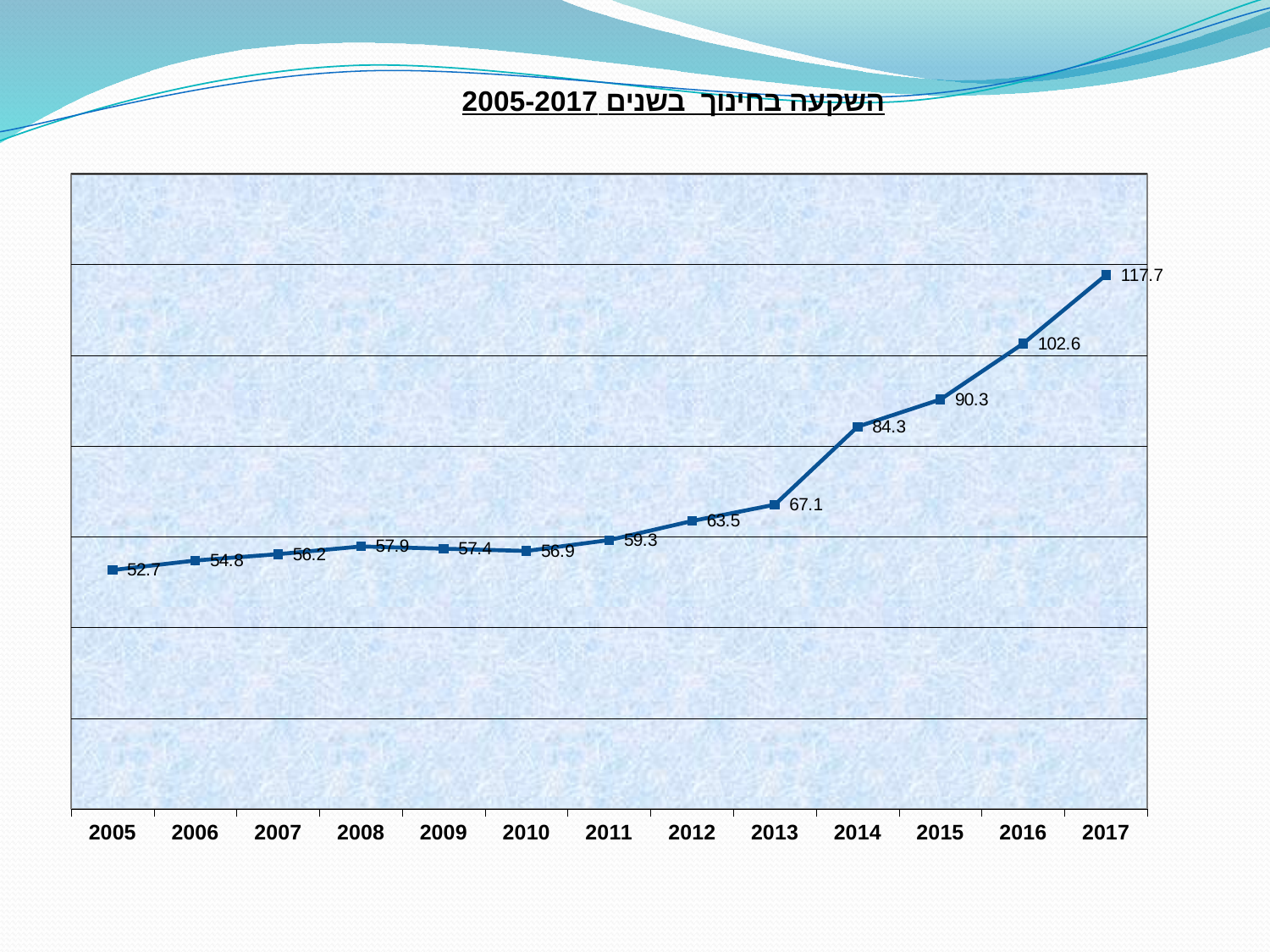
What is the difference between the values for 2017 and 2005? 65.0 Which year has the highest value? 2017 What is the value for 2010? 56.9 Overall, do the values rise or fall from 2005 to 2017? Rise What type of chart is shown on the slide? Line chart What is the difference between the values for 2014 and 2013? 17.2 What is the value for 2005? 52.7 Which year has the lowest value? 2005 What is the value for 2017? 117.7 How many years are plotted on the x axis? 13 What is the value for 2014? 84.3 Which is larger, the value for 2008 or the value for 2009? 2008